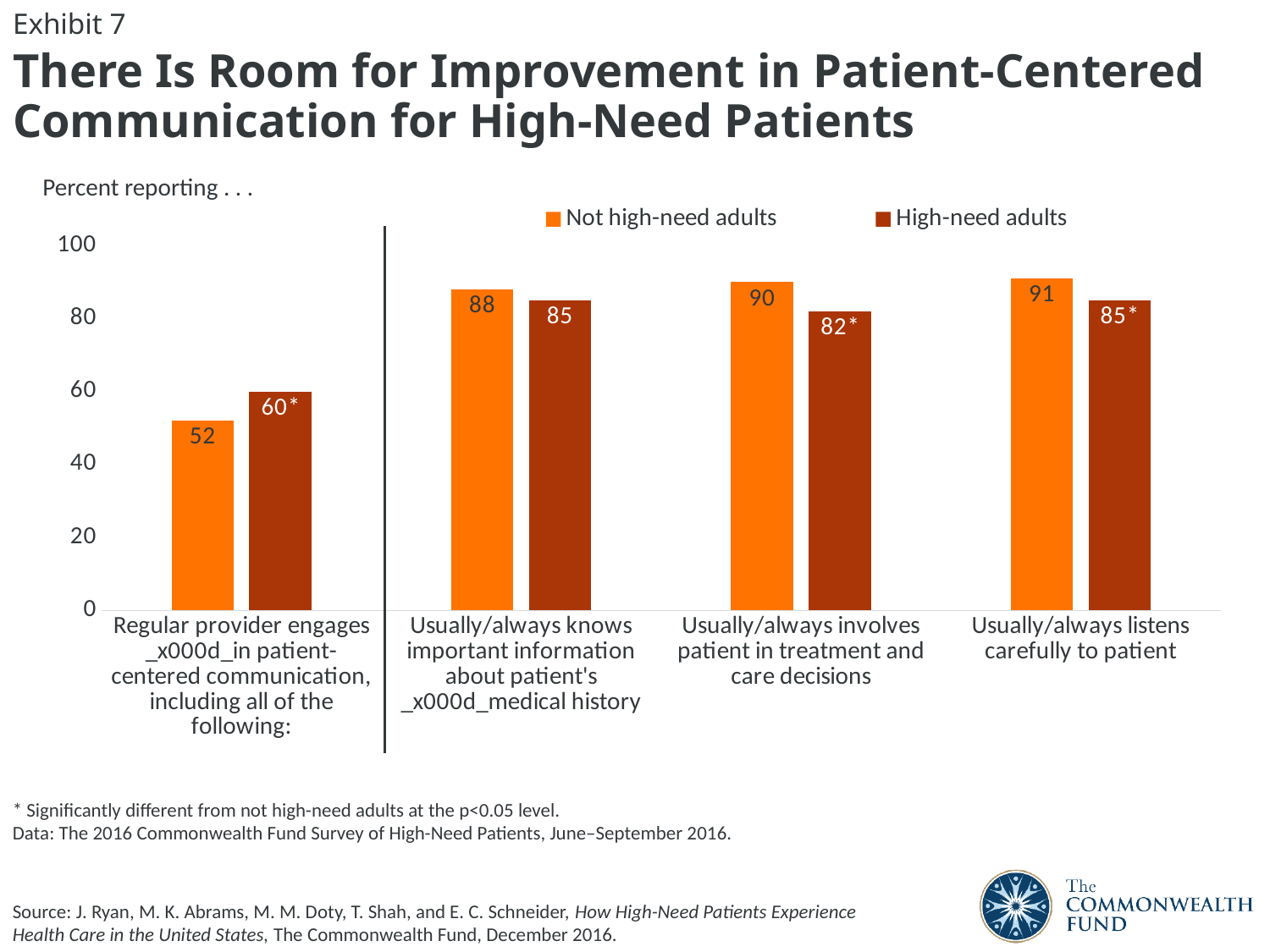
How many categories are shown on the x axis of the chart? 4 What kind of chart is shown on the slide? Bar chart Which category has the highest value for not high-need adults? Usually/always listens carefully to patient What is the difference between not high-need adults and high-need adults for usually/always involves patient in treatment and care decisions? 8 For the category 'Regular provider engages in patient-centered communication, including all of the following:', which group has the larger value, not high-need adults or high-need adults? High-need adults What percent of not high-need adults report that their regular provider engages in patient-centered communication, including all of the following? 52 What percent of not high-need adults report that their provider usually/always listens carefully to the patient? 91 Is the value for high-need adults for usually/always listens carefully to patient greater or less than 80? greater What percent of high-need adults report that their provider usually/always knows important information about the patient's medical history? 85 How many series does the legend list? 2 Which category has the lowest value for high-need adults? Regular provider engages in patient-centered communication, including all of the following: What percent of high-need adults report that their provider usually/always involves the patient in treatment and care decisions? 82